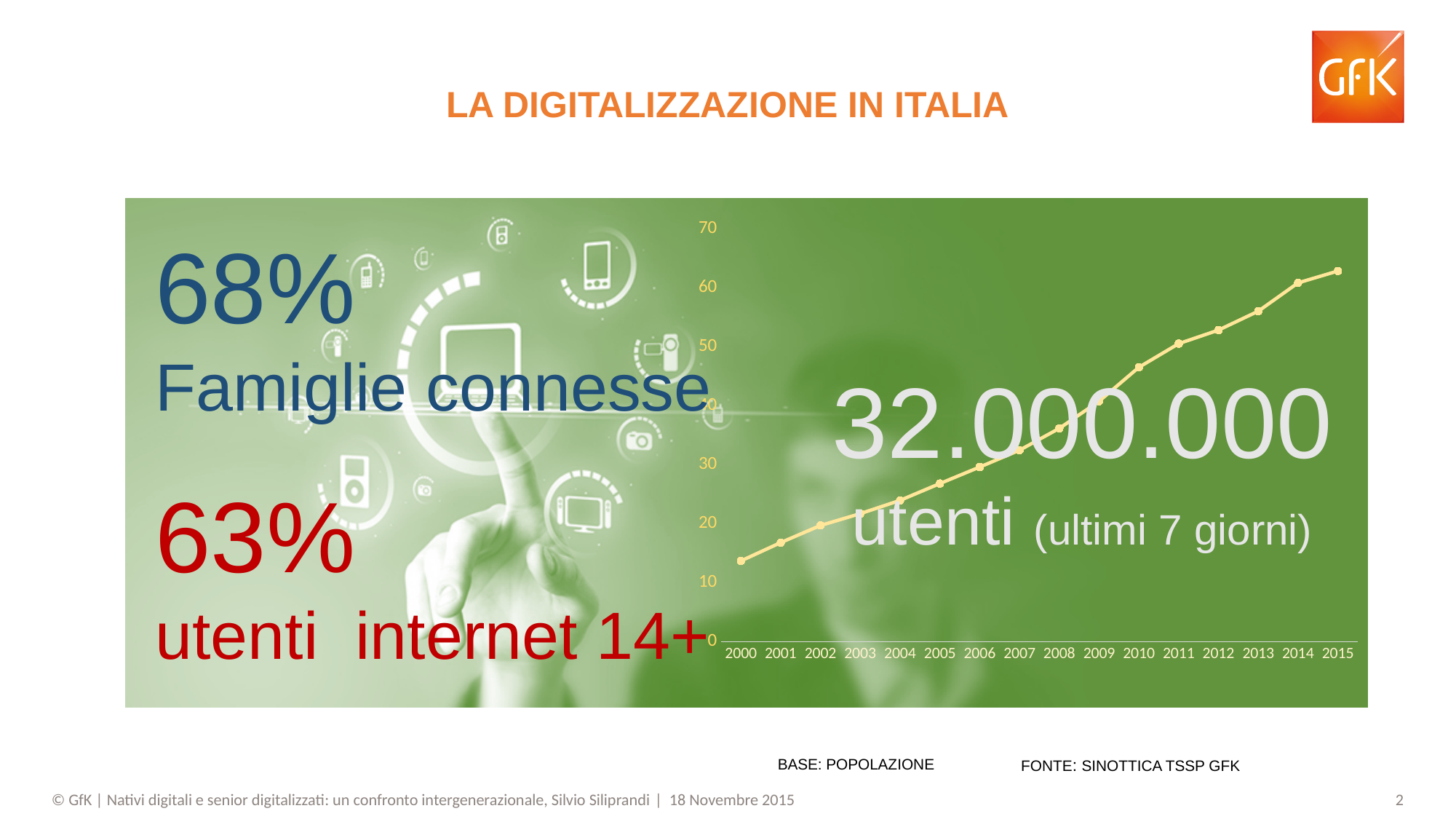
Which year has the lowest value in the line chart? 2000 Is the value for 2015 greater or less than 50? greater Do the values in the line chart rise or fall from 2000 to 2015? rise How many years are shown on the x axis of the line chart? 16 Which year has the larger value, 2005 or 2010? 2010 Is the value for 2000 greater or less than 20? less What kind of chart is shown on the slide? line chart Which year has the highest value in the line chart? 2015 Is the value for 2008 greater or less than 40? less What is the highest tick value shown on the y axis of the line chart? 70 What is the first year shown on the x axis of the line chart? 2000